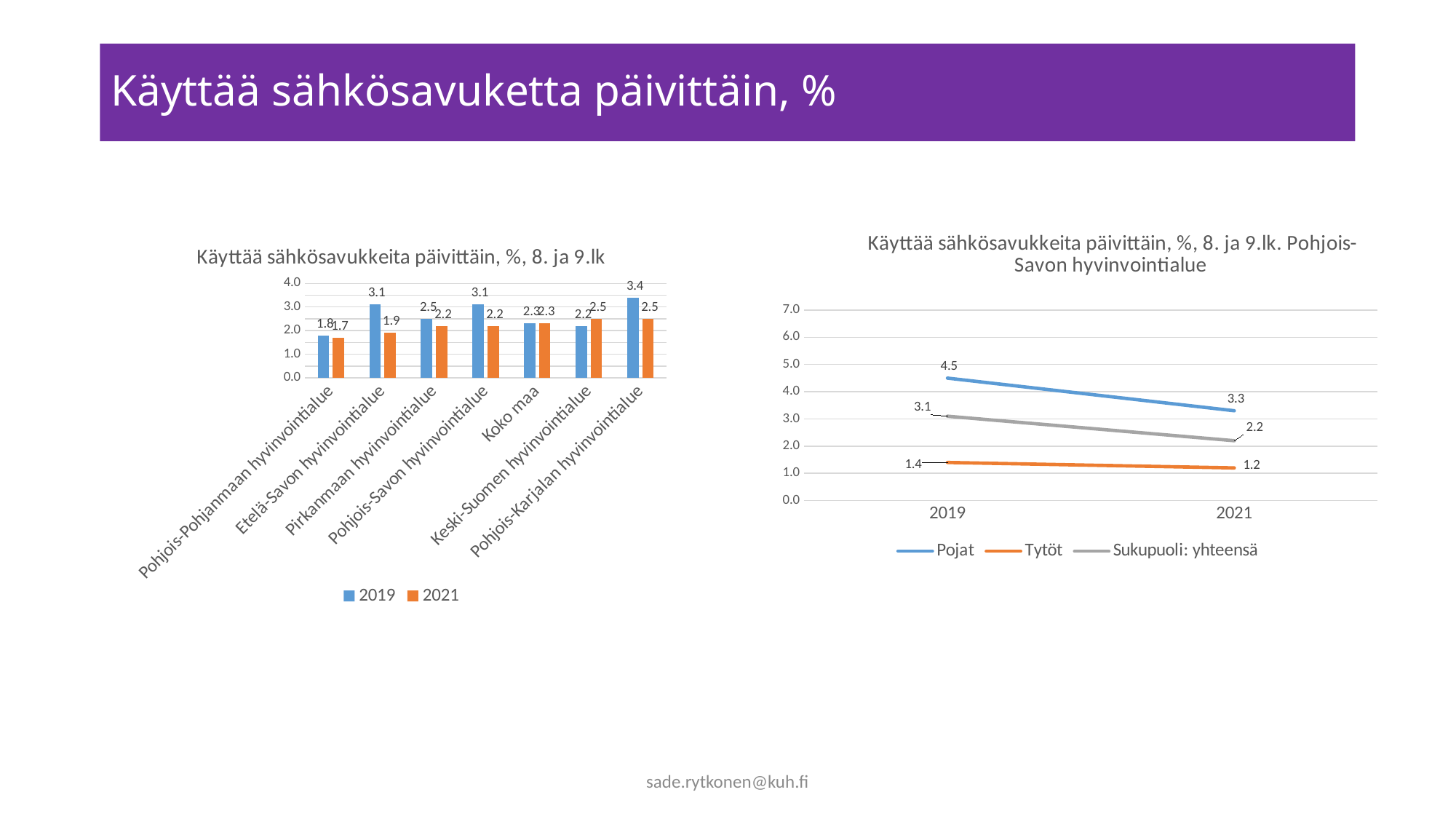
In the right line chart, what is the value for Pojat in 2019? 4.5 In the left bar chart, is the 2019 value for Pirkanmaan hyvinvointialue larger or the 2021 value? 2019 In the right line chart, what is the difference between the Pojat and Tytöt values in 2021? 2.1 In the left bar chart, which category has the highest 2019 value? Pohjois-Karjalan hyvinvointialue In the right line chart, does the Sukupuoli: yhteensä line rise or fall from 2019 to 2021? fall What kind of chart is the chart on the right of the slide? line chart In the left bar chart, what is the 2021 value for Etelä-Savon hyvinvointialue? 1.9 In the left bar chart, which category has the lowest 2021 value? Pohjois-Pohjanmaan hyvinvointialue In the left bar chart, what is the 2019 value for Pohjois-Savon hyvinvointialue? 3.1 In the left bar chart, what is the difference between the 2019 and 2021 values for Etelä-Savon hyvinvointialue? 1.2 How many categories are shown on the x axis of the left bar chart? 7 How many series does the legend of the left bar chart list? 2